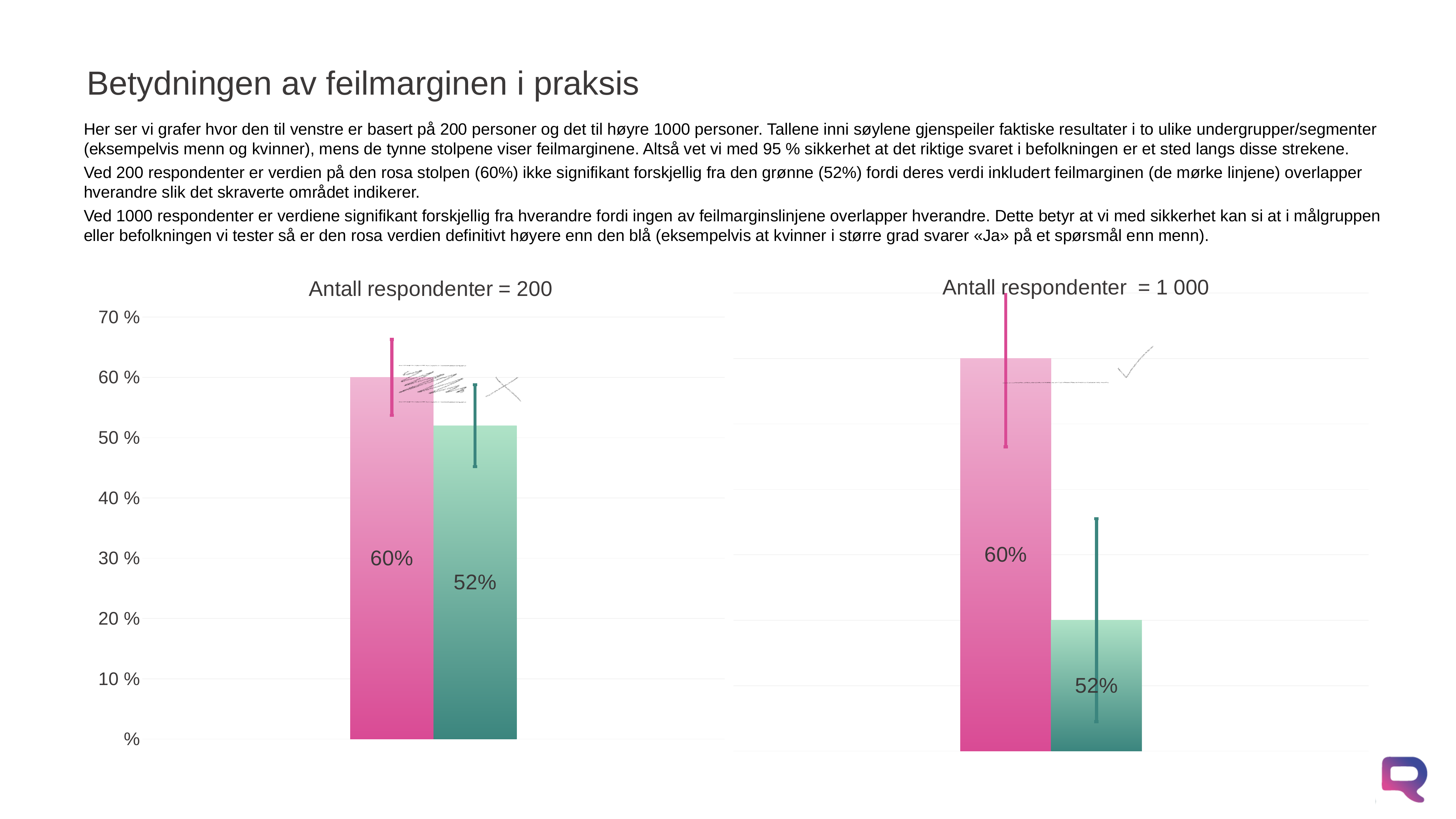
What kind of chart is the chart titled "Antall respondenter = 200"? bar chart In the chart titled "Antall respondenter = 200", is the value of the pink bar greater or less than 50 %? greater In the chart titled "Antall respondenter = 1 000", what value is labelled on the green bar? 52% In the chart titled "Antall respondenter = 200", what is the difference between the labelled values of the pink bar and the green bar? 8% In the chart titled "Antall respondenter = 200", what value is labelled on the pink bar? 60% What is the title of the chart on the right side of the slide? Antall respondenter = 1 000 In the chart titled "Antall respondenter = 200", is the value of the green bar greater or less than 60 %? less In the chart titled "Antall respondenter = 200", which bar has the larger labelled value, the pink bar or the green bar? the pink bar In the chart titled "Antall respondenter = 200", which bar has the lowest labelled value? the green bar How many bars are plotted in the chart titled "Antall respondenter = 200"? 2 In the chart titled "Antall respondenter = 1 000", what value is labelled on the pink bar? 60% In the chart titled "Antall respondenter = 200", what value is labelled on the green bar? 52%